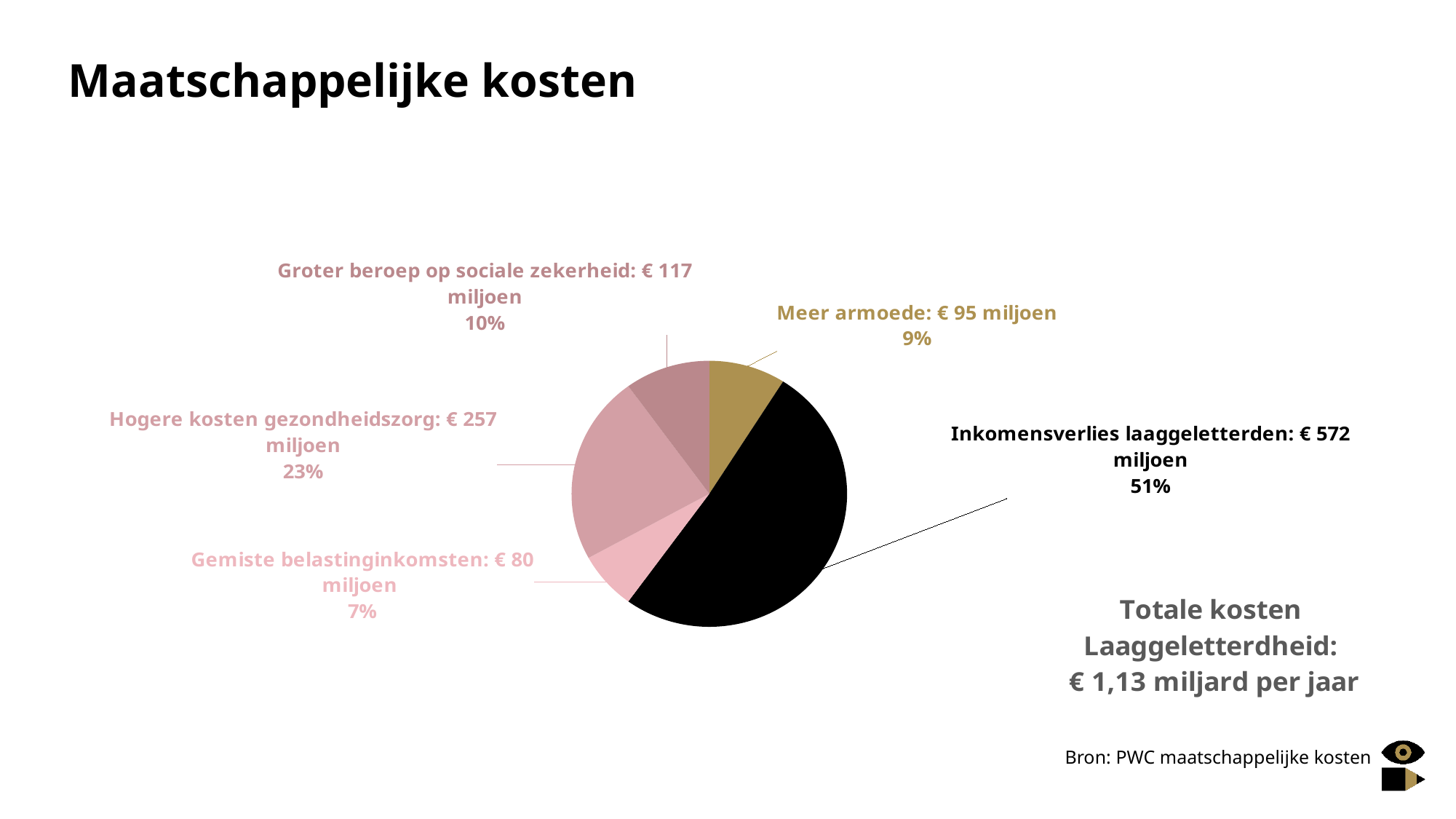
What is the difference between the values for Inkomensverlies laaggeletterden and Hogere kosten gezondheidszorg? € 315 miljoen What share of the pie does Groter beroep op sociale zekerheid represent? 10% How many slices does the pie chart have? 5 What share of the pie does Gemiste belastinginkomsten represent? 7% What is the value for Meer armoede? € 95 miljoen Which is larger, the value for Groter beroep op sociale zekerheid or the value for Meer armoede? Groter beroep op sociale zekerheid Which category has the smallest slice of the pie? Gemiste belastinginkomsten What is the title of the slide containing the pie chart? Maatschappelijke kosten What is the value for Inkomensverlies laaggeletterden? € 572 miljoen Which category has the largest slice of the pie? Inkomensverlies laaggeletterden What kind of chart is shown on the slide? pie chart What is the value for Hogere kosten gezondheidszorg? € 257 miljoen